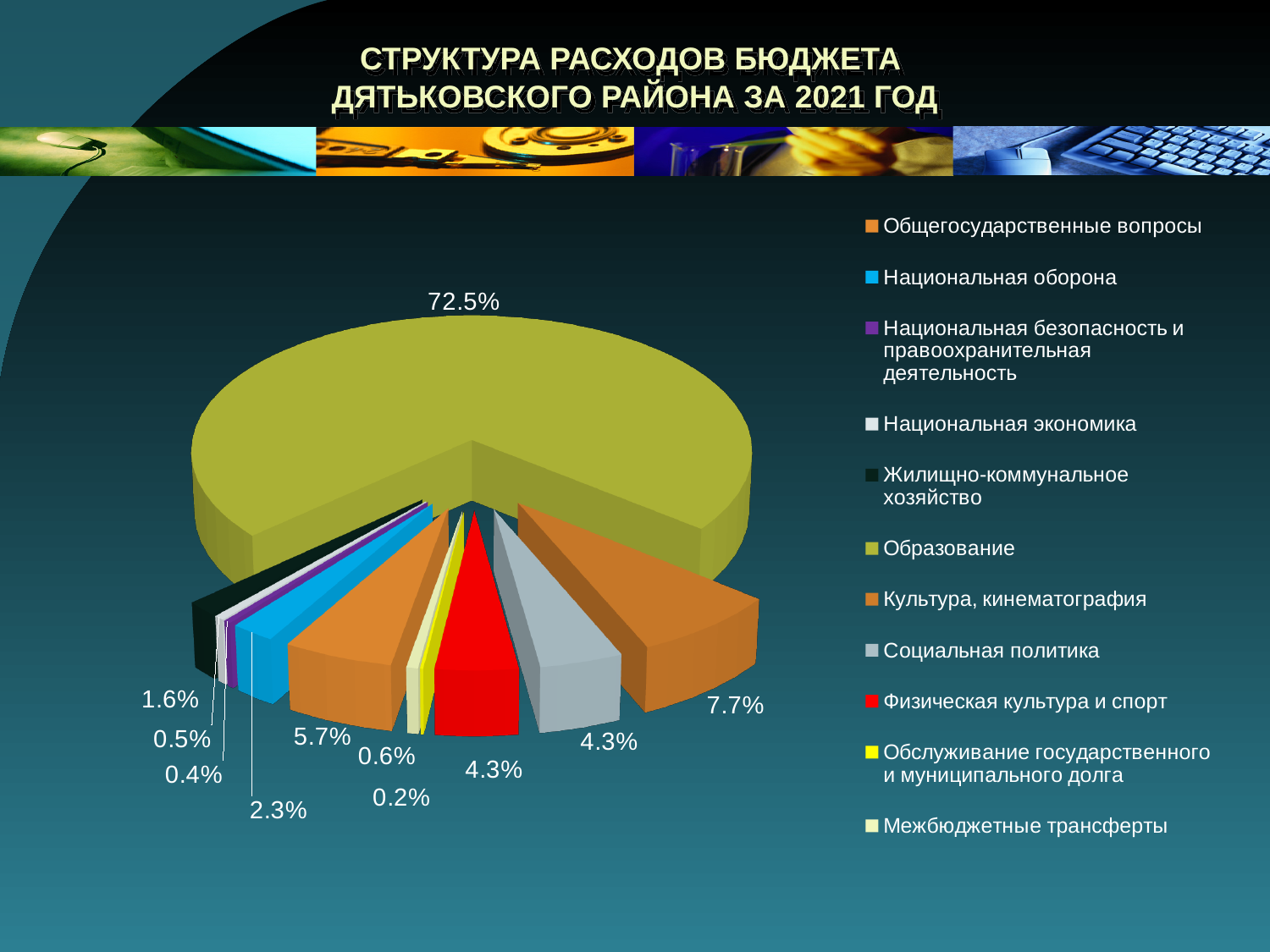
What share of the budget expenditure goes to Обслуживание государственного и муниципального долга? 0.2% What share of the budget expenditure goes to Жилищно-коммунальное хозяйство? 1.6% What share of the budget expenditure goes to Образование? 72.5% What is the difference between the share for Образование and the share for Культура, кинематография? 64.8% Which category has the smallest share of the pie? Обслуживание государственного и муниципального долга What share of the budget expenditure goes to Национальная оборона? 2.3% Which is larger: the share for Национальная оборона or the share for Жилищно-коммунальное хозяйство? Национальная оборона What kind of chart is shown on the slide? pie chart What share of the budget expenditure goes to Культура, кинематография? 7.7% Which category has the largest share of the pie? Образование How many categories does the legend of the pie chart list? 11 What share of the budget expenditure goes to Физическая культура и спорт? 4.3%